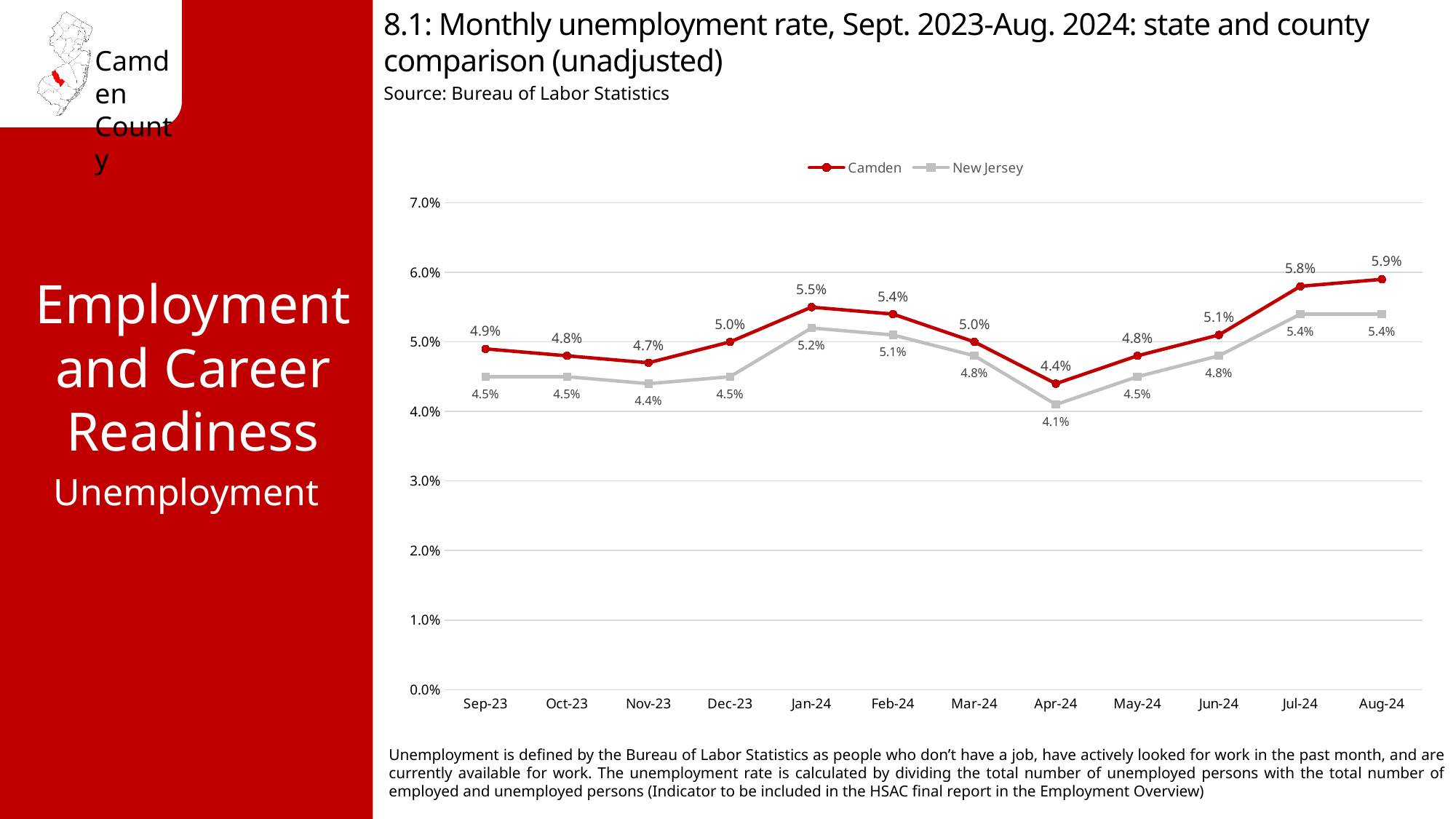
What is the difference between the Camden and New Jersey unemployment rates in Aug-24? 0.5% How many months are shown on the x axis? 12 What is the source cited for the chart? Bureau of Labor Statistics What was the Camden unemployment rate in Jan-24? 5.5% In which month was the Camden unemployment rate lowest? Apr-24 How many series does the legend list? 2 What was the New Jersey unemployment rate in Nov-23? 4.4% Did the Camden unemployment rate rise or fall from Apr-24 to Aug-24? Rise What was the New Jersey unemployment rate in Apr-24? 4.1% In which month was the Camden unemployment rate highest? Aug-24 Which was higher in Jun-24, the Camden rate or the New Jersey rate? Camden What kind of chart is shown on the slide? Line chart